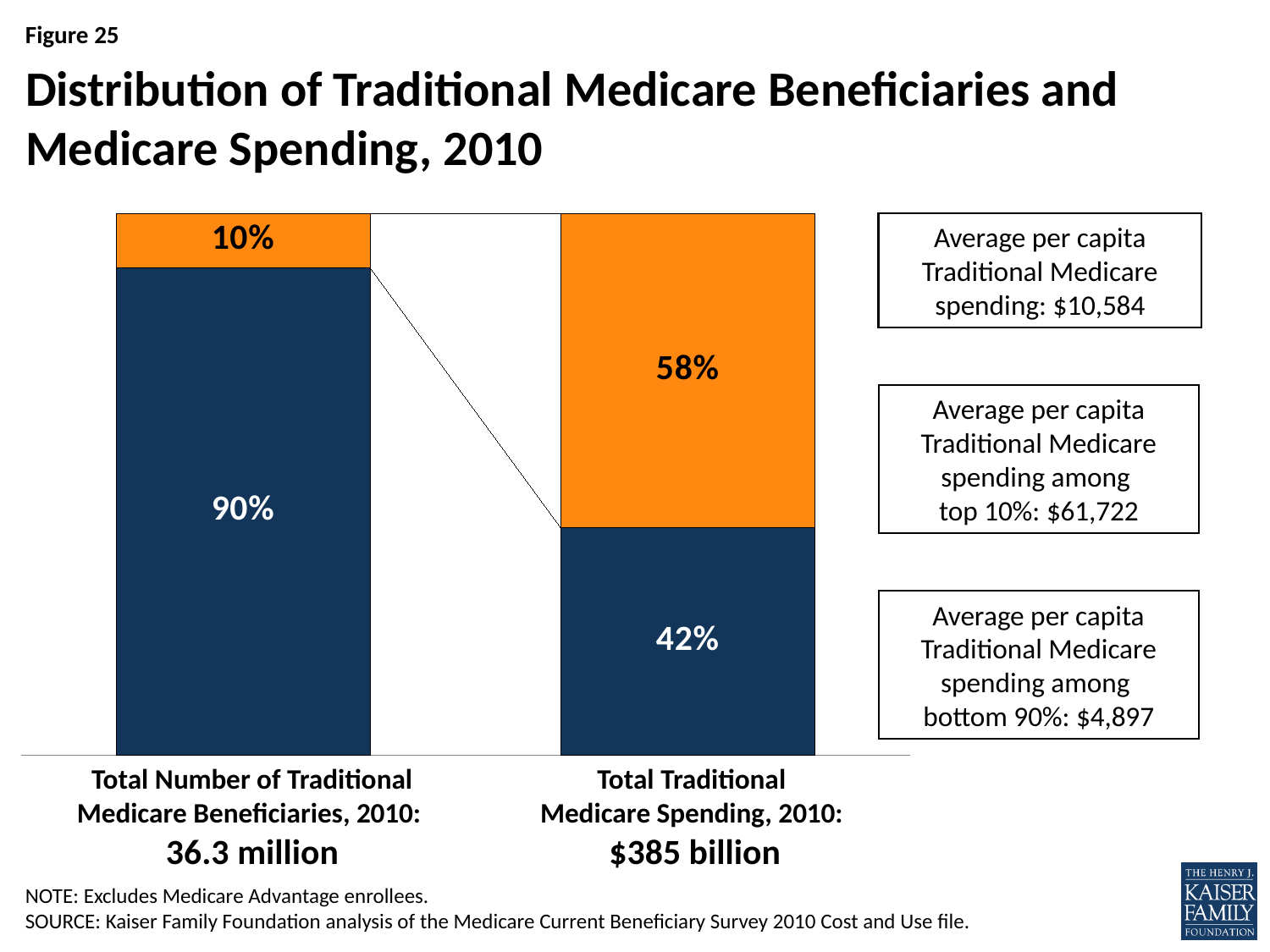
What share of Total Traditional Medicare Spending, 2010 is attributed to the bottom 90% of beneficiaries (dark blue segment)? 42% What is the total of the two segments in the Total Traditional Medicare Spending, 2010 bar? 100% What percentage of Total Number of Traditional Medicare Beneficiaries, 2010 does the orange segment represent? 10% According to the text box on the slide, what is the average per capita Traditional Medicare spending among the top 10%? $61,722 How many stacked bars are shown in the chart? 2 What kind of chart is shown on the slide? Stacked bar chart What is the total Traditional Medicare spending in 2010 shown below the right bar? $385 billion What share of Total Traditional Medicare Spending, 2010 is attributed to the top 10% of beneficiaries (orange segment)? 58% What is the difference in percentage points between the orange segment of the spending bar and the orange segment of the beneficiaries bar? 48 percentage points What percentage of Total Number of Traditional Medicare Beneficiaries, 2010 does the dark blue segment represent? 90% What is the total number of Traditional Medicare beneficiaries in 2010 shown below the left bar? 36.3 million In the Total Traditional Medicare Spending, 2010 bar, which segment is larger, the orange (top 10%) or the dark blue (bottom 90%)? Orange (top 10%)